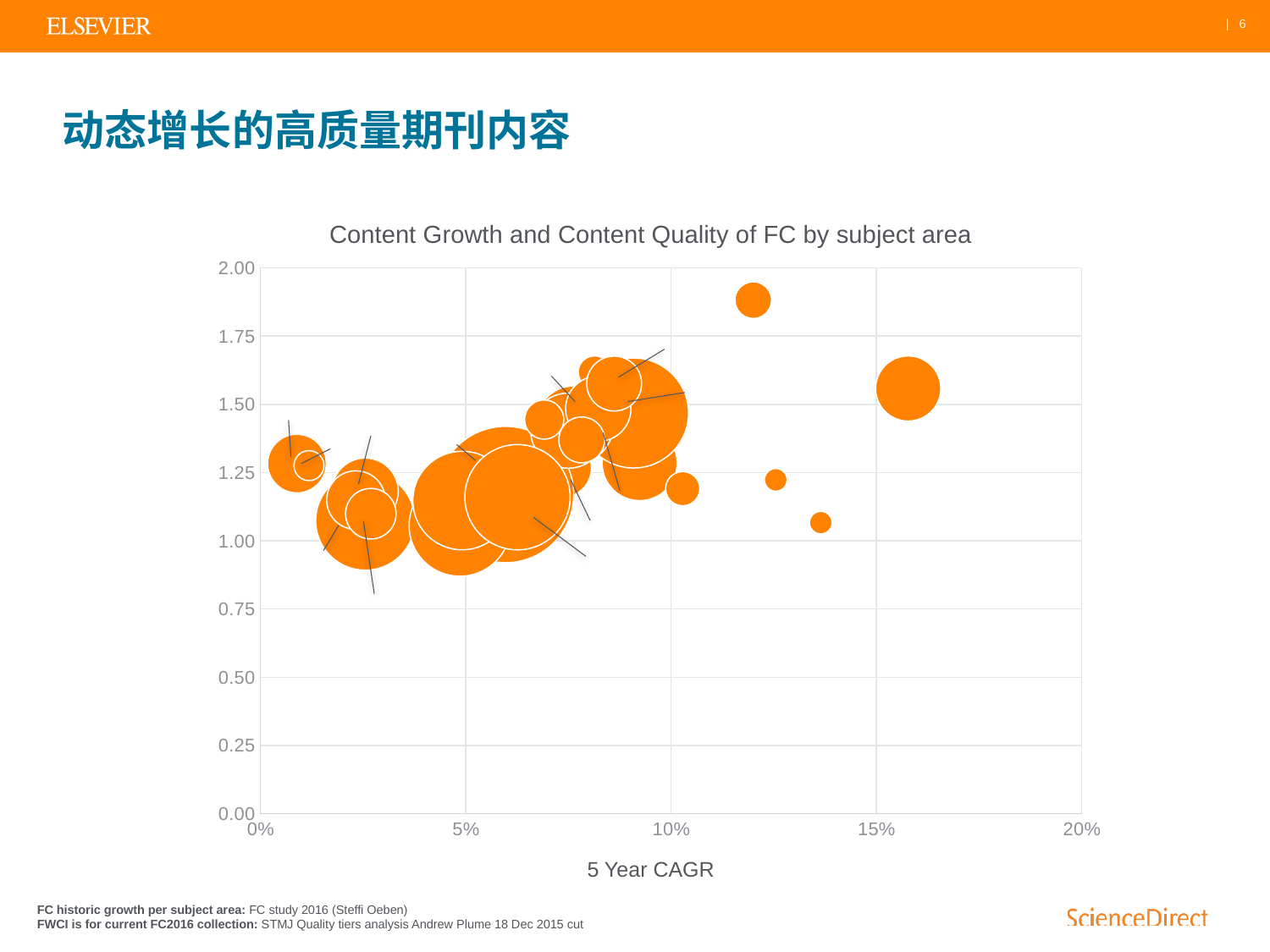
Is the 5 Year CAGR of the topmost bubble greater or less than 10%? greater What is the title of the chart? Content Growth and Content Quality of FC by subject area Is the vertical-axis value of the topmost bubble greater or less than 1.75? greater Is the 5 Year CAGR of the rightmost bubble greater or less than 15%? greater What kind of chart is shown on the slide? bubble chart What is the label of the horizontal axis of the chart? 5 Year CAGR